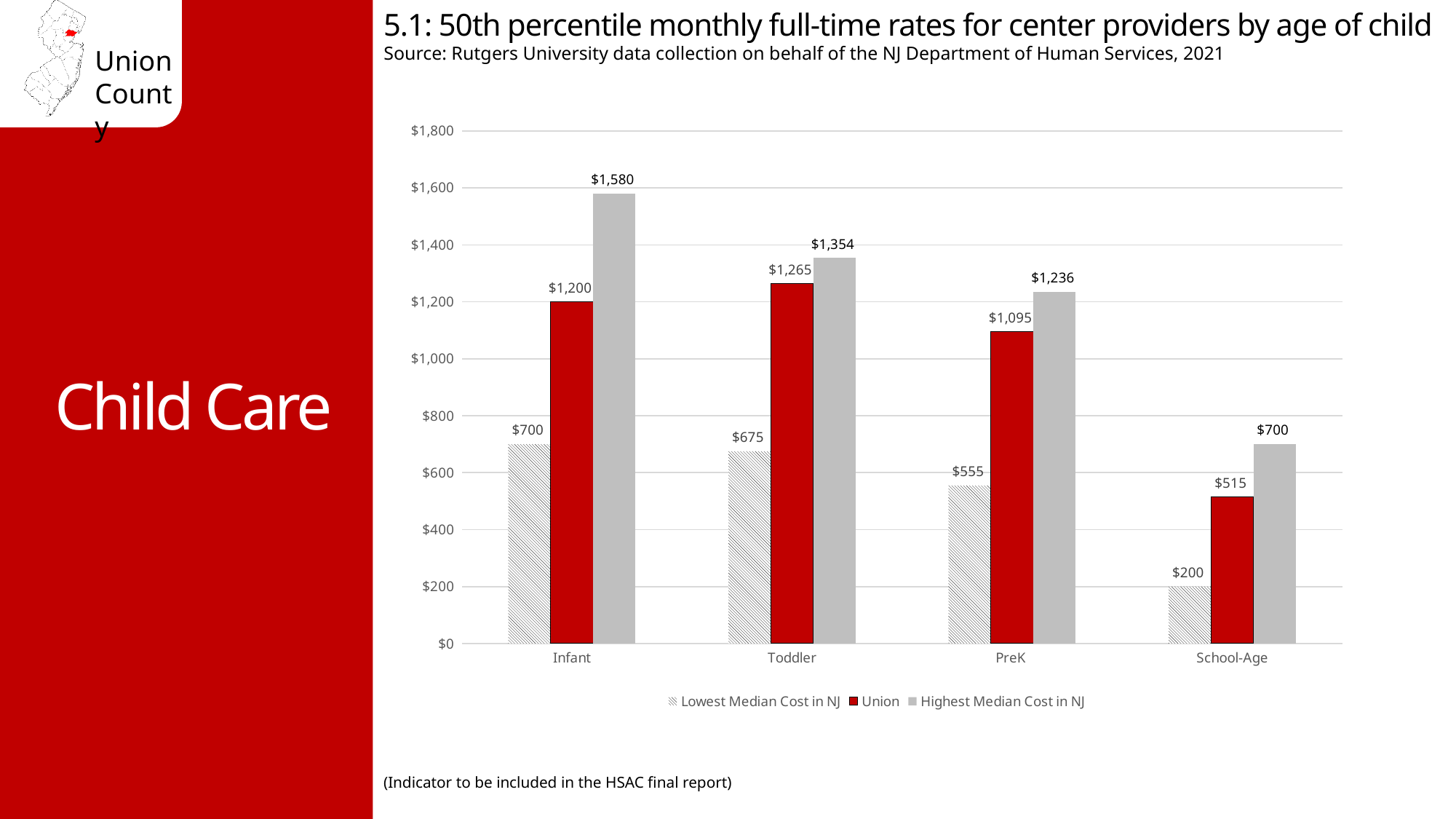
Which age category has the highest Union value? Toddler How many series does the legend list? 3 What kind of chart is shown on the slide? Bar chart What is the Lowest Median Cost in NJ for School-Age? $200 How many age categories are shown on the x axis? 4 Which age category has the lowest Highest Median Cost in NJ value? School-Age What is the difference between the Union value and the Lowest Median Cost in NJ for PreK? $540 What is the difference between the Highest Median Cost in NJ and the Union value for Infant? $380 What is the Highest Median Cost in NJ for Toddler? $1,354 Do the Union values rise or fall from Toddler to School-Age along the x axis? Fall What is the Union value for Infant? $1,200 Which is larger, the Union value for PreK or the Union value for School-Age? PreK